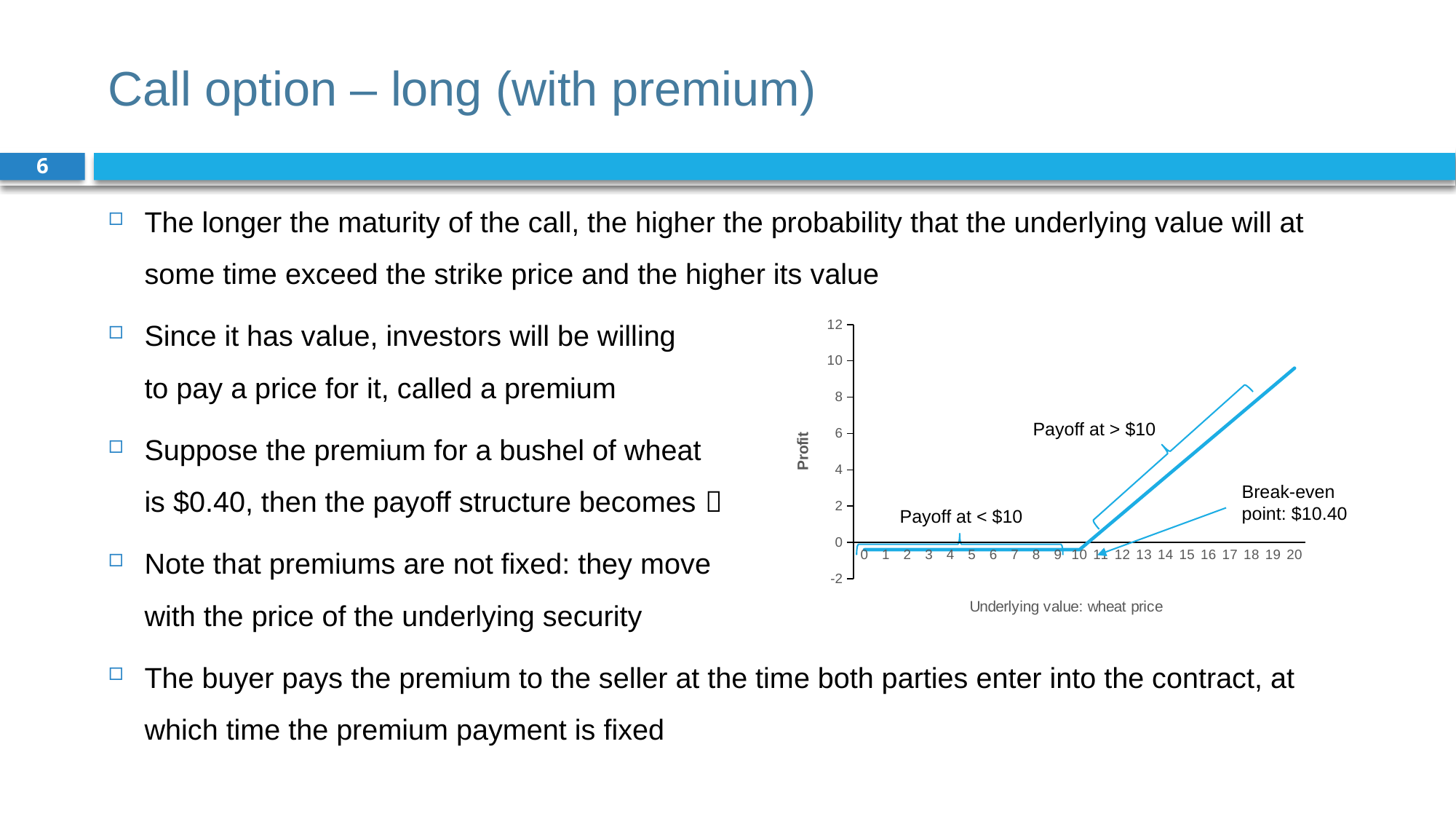
Does the profit line rise or fall as the wheat price increases from 10 to 20? rise What is the title of the horizontal axis of the chart? Underlying value: wheat price Is the profit at a wheat price of 5 greater or less than 2? less How many tick labels are shown on the horizontal axis of the chart? 21 What kind of chart is shown on the slide? line chart Which is larger, the profit at a wheat price of 20 or the profit at a wheat price of 12? wheat price of 20 According to the annotation on the chart, what is the break-even point? $10.40 Is the profit at a wheat price of 20 greater or less than 8? greater Is the profit at a wheat price of 18 greater or less than 10? less What is the highest value labelled on the vertical axis of the chart? 12 What is the title of the vertical axis of the chart? Profit